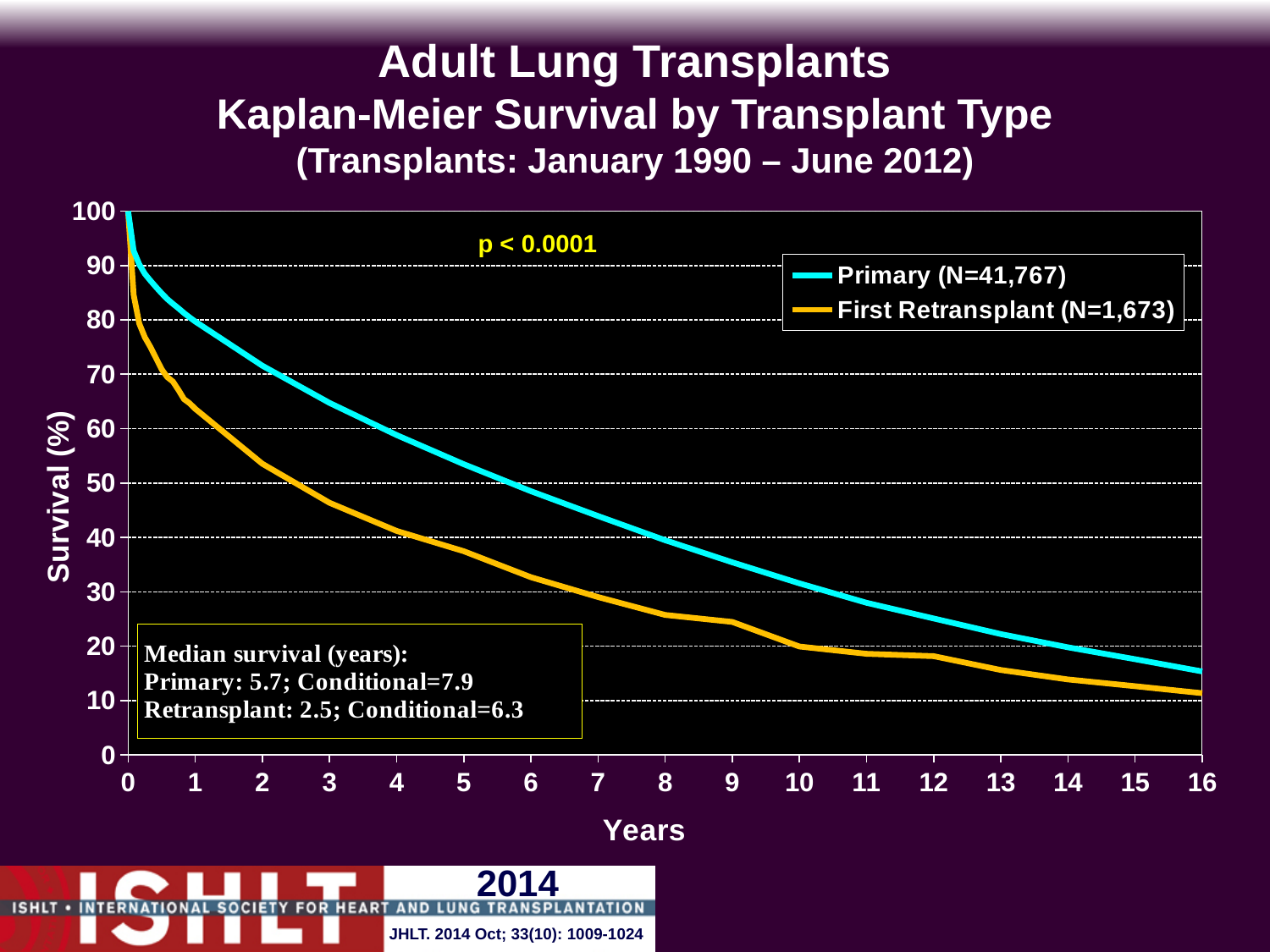
What is the difference in median survival (years) between Primary transplants and Retransplants? 3.2 What is the median survival in years for Retransplants? 2.5 What kind of chart is shown on the slide? line chart What is the number of patients (N) in the First Retransplant group shown in the legend? 1,673 What is the conditional median survival in years for Retransplants? 6.3 Do the survival curves rise or fall as years increase? fall At 8 years, which curve shows higher survival, Primary or First Retransplant? Primary Is the survival value for the Primary curve at 5 years greater or less than 50? greater How many series does the legend list? 2 What is the median survival in years for Primary transplants? 5.7 What is the number of patients (N) in the Primary group shown in the legend? 41,767 What is the conditional median survival in years for Primary transplants? 7.9